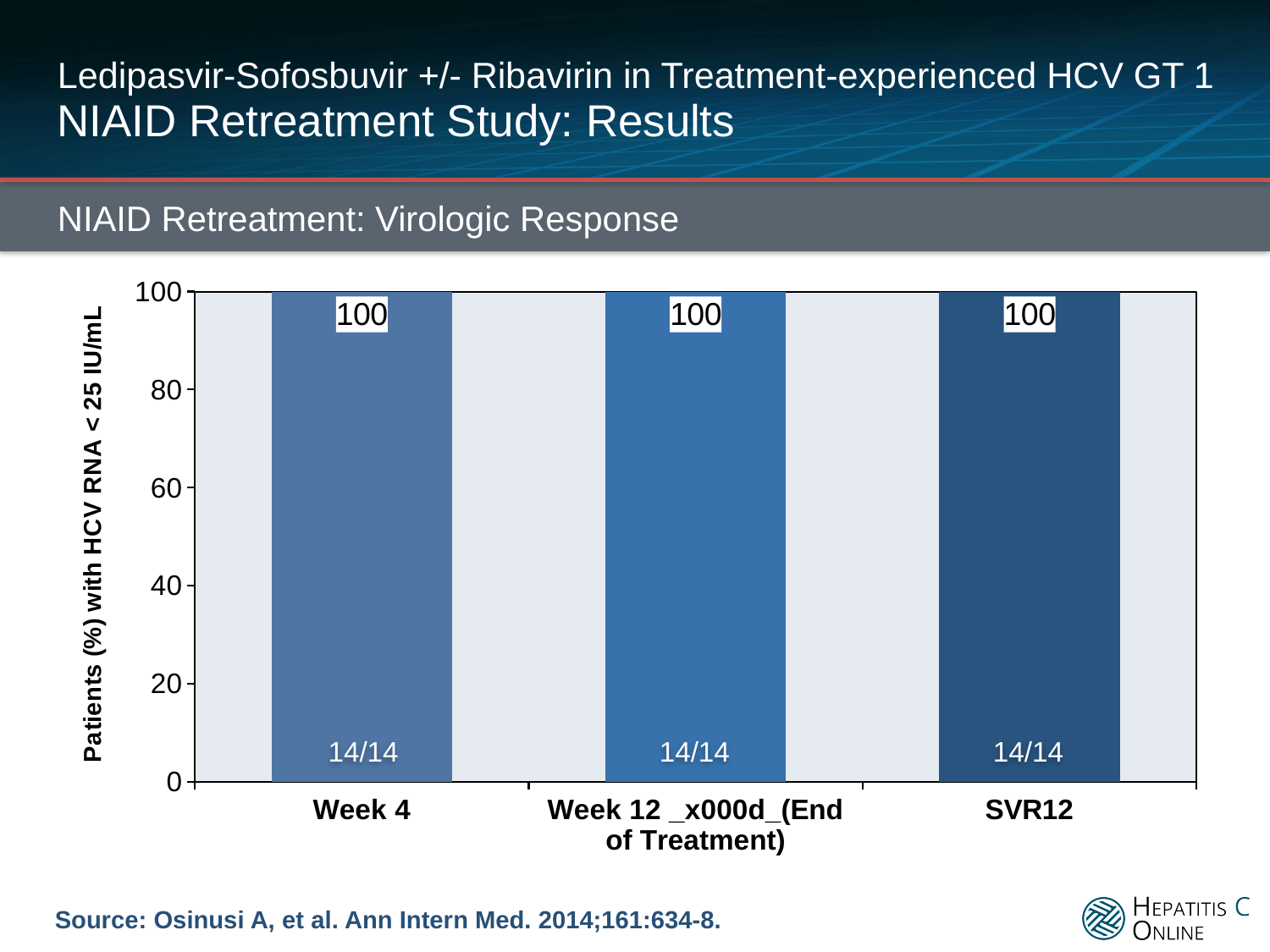
Do the values rise, fall, or stay the same from Week 4 to SVR12? stay the same How many categories are shown on the x axis? 3 What kind of chart is this? bar chart What is the value for Week 12 (End of Treatment)? 100 What fraction of patients is shown inside the SVR12 bar? 14/14 What is the title of the chart? NIAID Retreatment: Virologic Response What is the difference between the values for Week 4 and SVR12? 0 Is the value for Week 4 greater or less than 80? greater What is the y-axis label of the chart? Patients (%) with HCV RNA < 25 IU/mL What is the value for Week 4? 100 What fraction of patients is shown inside the Week 4 bar? 14/14 What is the value for SVR12? 100